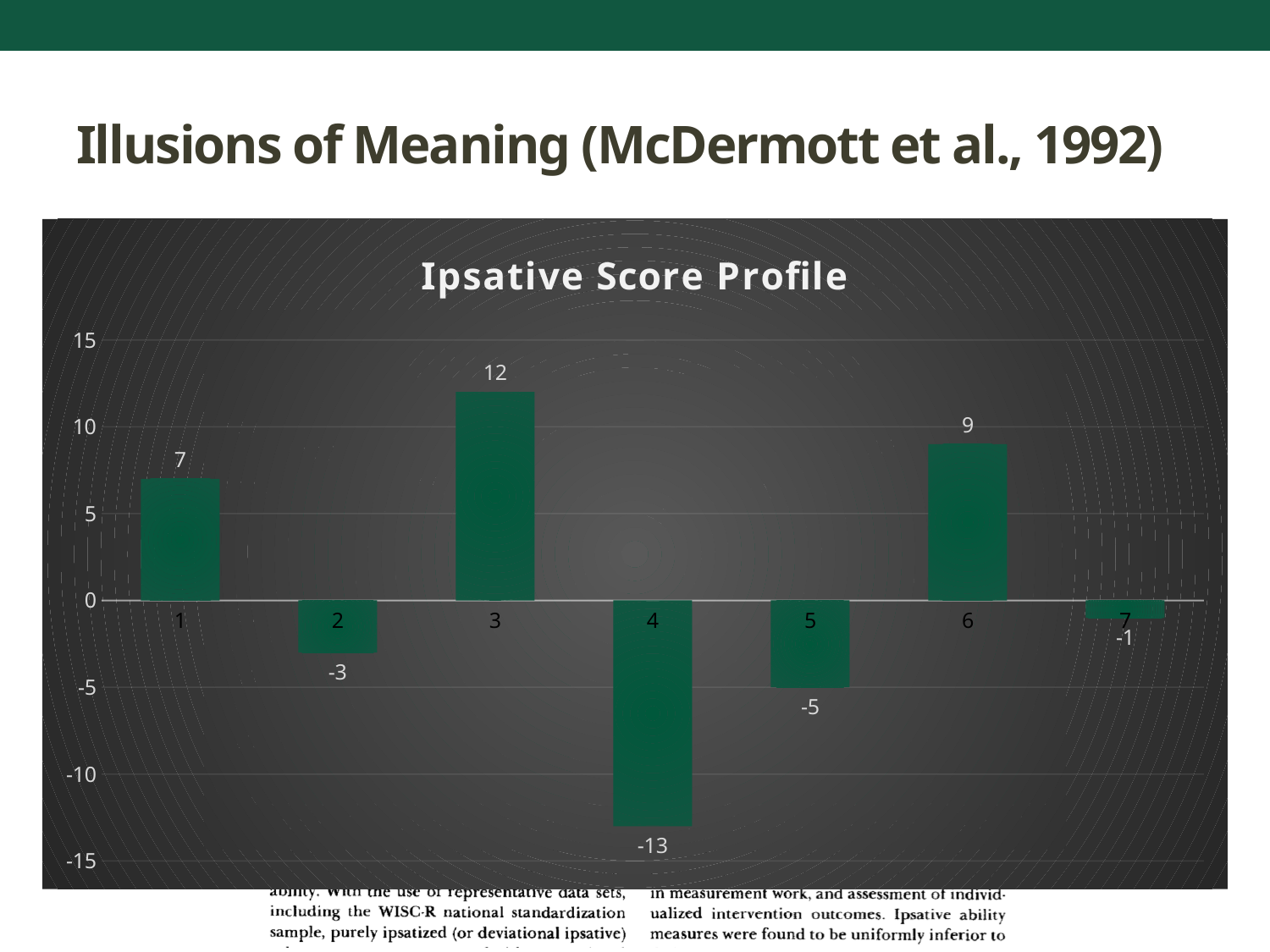
Which has the larger value, category 1 or category 6? 6 Which category has the lowest value in the Ipsative Score Profile chart? 4 Which category has the highest value in the Ipsative Score Profile chart? 3 What kind of chart is shown on the slide? bar chart How many categories are shown in the Ipsative Score Profile chart? 7 What is the value for category 6 in the Ipsative Score Profile chart? 9 Is the value for category 4 greater or less than -10? less What is the title of the chart on the slide? Ipsative Score Profile What is the difference between the values for category 3 and category 6? 3 What is the value for category 3 in the Ipsative Score Profile chart? 12 What is the value for category 7 in the Ipsative Score Profile chart? -1 What is the value for category 4 in the Ipsative Score Profile chart? -13